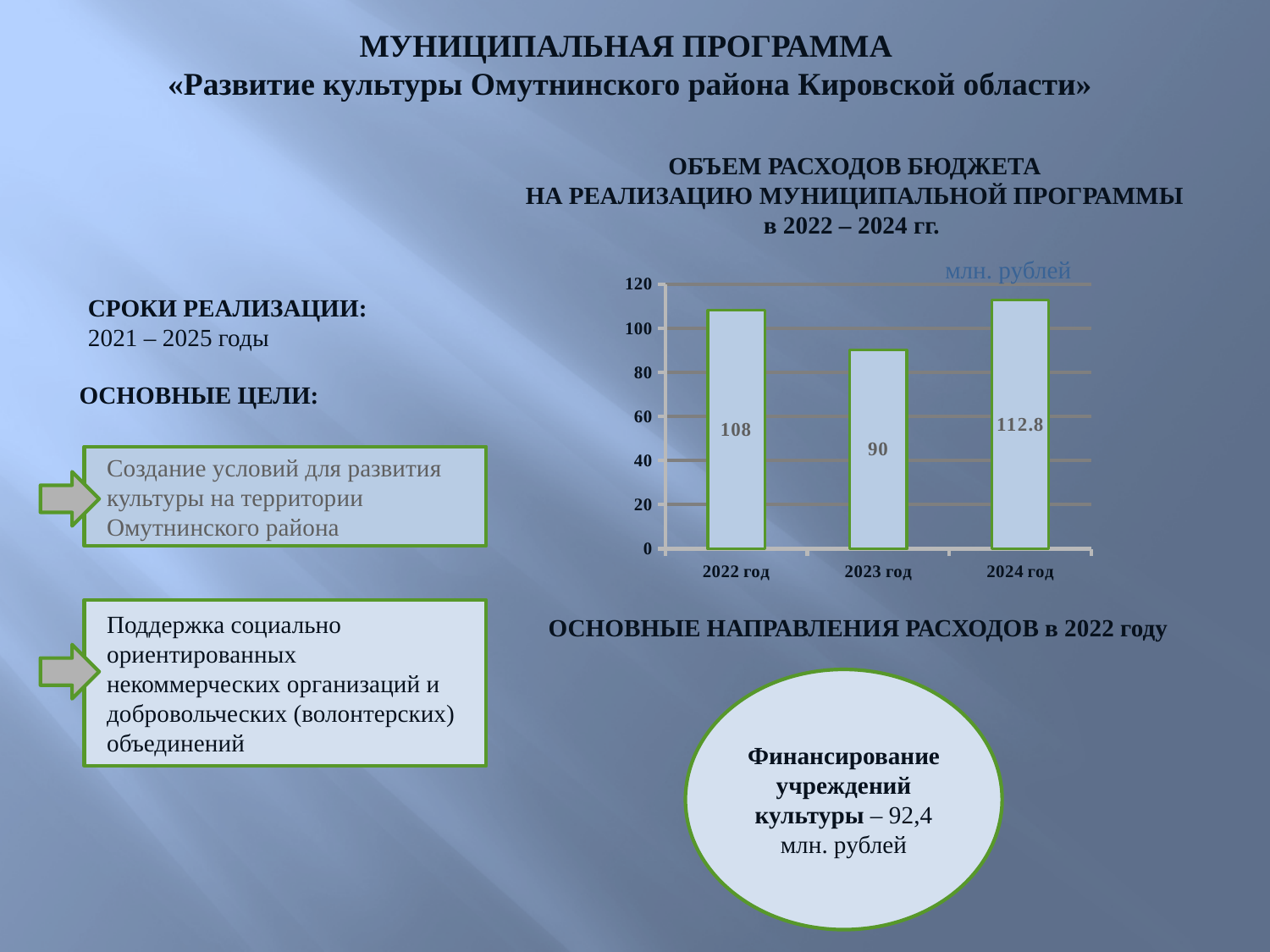
What type of chart is used to show the budget expenditure for 2022–2024? bar chart Is the value for 2023 год greater or less than 100? less Which year has the highest budget expenditure in the chart? 2024 год Which year has the lowest budget expenditure in the chart? 2023 год Which is larger, the value for 2022 год or the value for 2023 год? 2022 год What is the budget expenditure value shown for 2024 год? 112.8 What is the difference between the values for 2022 год and 2023 год? 18 What is the difference between the values for 2024 год and 2022 год? 4.8 What unit of measurement is indicated for the values in the chart? млн. рублей What is the budget expenditure value shown for 2023 год? 90 How many years (categories) are shown in the bar chart? 3 What is the budget expenditure value shown for 2022 год? 108